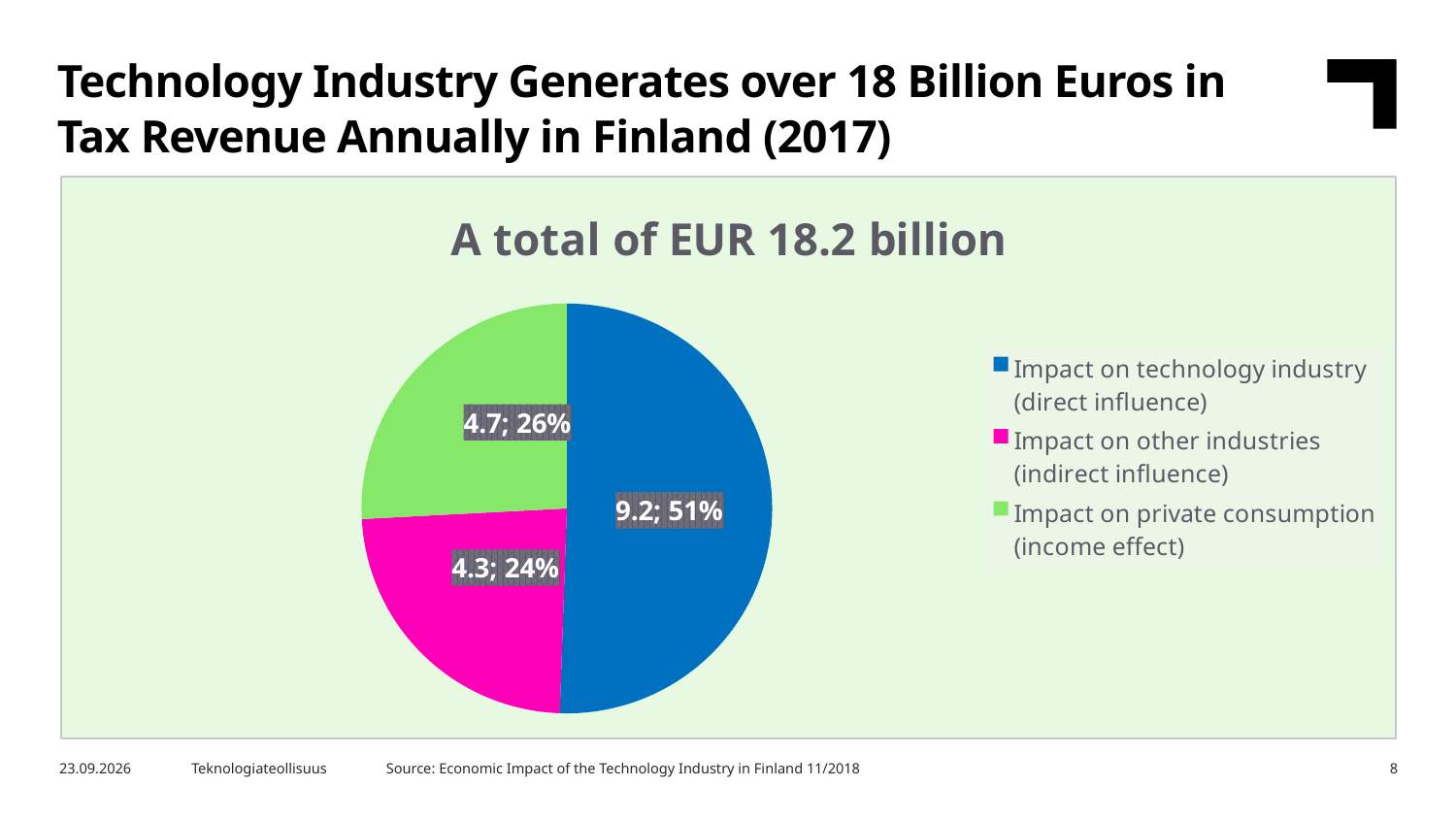
What kind of chart is shown on the slide? Pie chart Which category has the smallest slice? Impact on other industries (indirect influence) What value is shown for Impact on technology industry (direct influence)? 9.2 Which category has the largest slice? Impact on technology industry (direct influence) Which colour represents Impact on other industries (indirect influence)? Pink What value is shown for Impact on other industries (indirect influence)? 4.3 What is the chart's title? A total of EUR 18.2 billion How many slices does the pie chart have? 3 What is the difference between the values for Impact on technology industry (direct influence) and Impact on private consumption (income effect)? 4.5 What share of the pie does Impact on private consumption (income effect) represent? 26% What share of the pie does Impact on technology industry (direct influence) represent? 51% What value is shown for Impact on private consumption (income effect)? 4.7